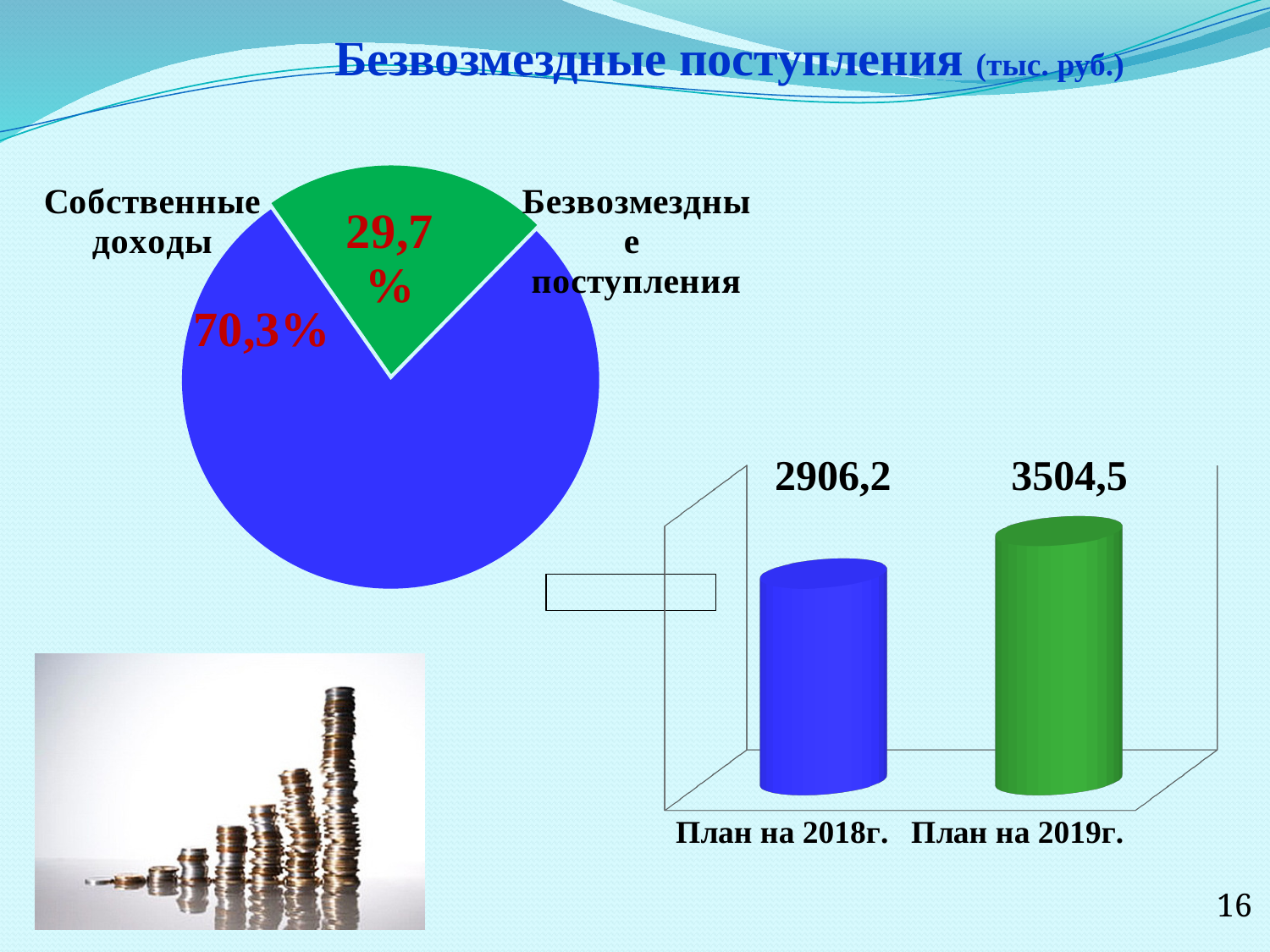
In the pie chart, what share is labelled for Собственные доходы? 70,3% In the bar chart at the bottom right, what is the difference between the values for План на 2019г. and План на 2018г.? 598,3 In the pie chart, which slice is larger: Собственные доходы or Безвозмездные поступления? Собственные доходы In the bar chart at the bottom right, do the values rise or fall from План на 2018г. to План на 2019г.? Rise How many slices does the pie chart have? 2 In the bar chart at the bottom right, which category has the lower value? План на 2018г. In the bar chart at the bottom right, what is the value for План на 2019г.? 3504,5 What kind of chart is shown at the bottom right of the slide? Bar chart In the bar chart at the bottom right, what is the value for План на 2018г.? 2906,2 In the pie chart, what colour is the slice for Безвозмездные поступления? Green In the bar chart at the bottom right, which category has the higher value? План на 2019г. In the pie chart, what share is labelled for Безвозмездные поступления? 29,7%